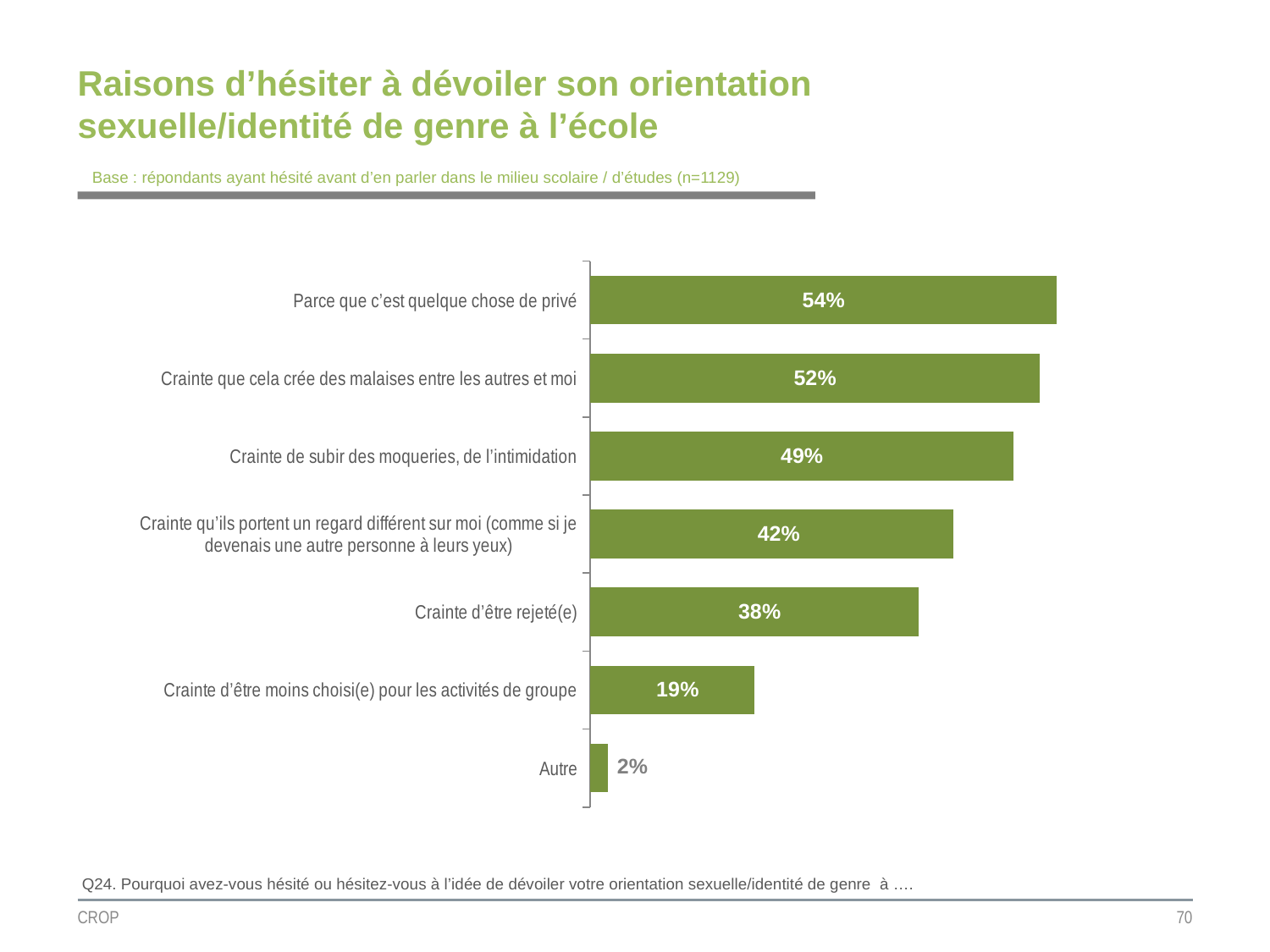
Which category has the lowest value? Autre What is the value for "Crainte qu’ils portent un regard différent sur moi (comme si je devenais une autre personne à leurs yeux)"? 42% What is the difference between "Crainte de subir des moqueries, de l’intimidation" and "Crainte d’être rejeté(e)"? 11% How many categories are shown in the chart? 7 What is the value for "Crainte d’être rejeté(e)"? 38% Which category has the highest value? Parce que c’est quelque chose de privé What is the difference between the highest and lowest values in the chart? 52% What is the value for "Crainte d’être moins choisi(e) pour les activités de groupe"? 19% Which is larger: "Crainte que cela crée des malaises entre les autres et moi" or "Crainte qu’ils portent un regard différent sur moi"? Crainte que cela crée des malaises entre les autres et moi What is the value for "Parce que c’est quelque chose de privé"? 54% What kind of chart is shown on the slide? Bar chart What is the base size (n) stated on the slide? n=1129